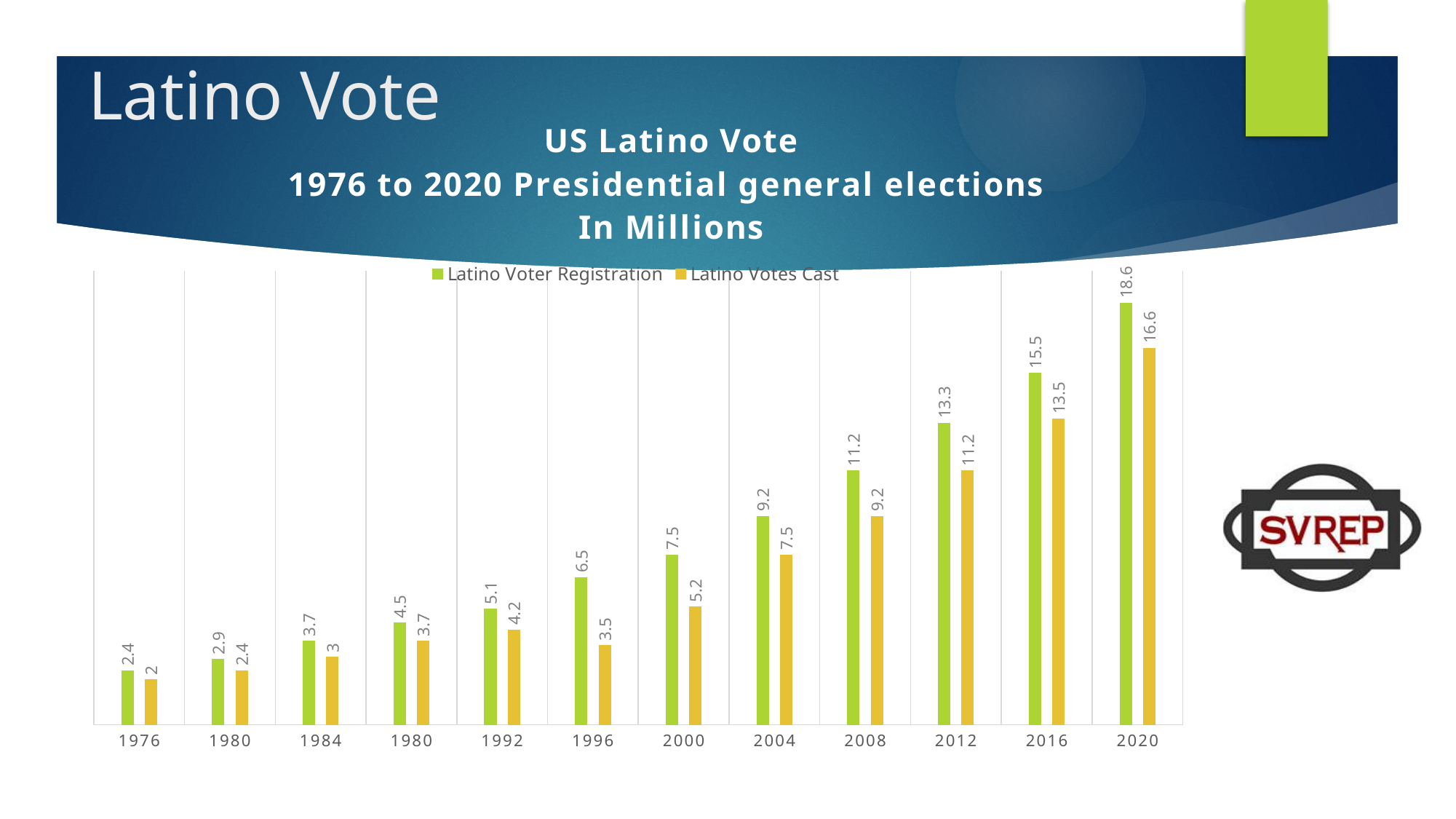
How many series does the legend list? 2 What is the Latino Voter Registration value for 2020? 18.6 What is the Latino Voter Registration value for 1992? 5.1 What is the difference between Latino Voter Registration in 2016 and in 2012? 2.2 What is the Latino Votes Cast value for 2016? 13.5 What kind of chart is shown on the slide? Bar chart Which year has the highest Latino Votes Cast value? 2020 Which is larger: Latino Votes Cast in 2008 or Latino Voter Registration in 2004? They are equal (9.2) What is the difference between Latino Voter Registration and Latino Votes Cast in 2020? 2 Which year has the lowest Latino Voter Registration value? 1976 What is the Latino Votes Cast value for 1996? 3.5 Do the Latino Voter Registration values rise or fall from 1976 to 2020? Rise